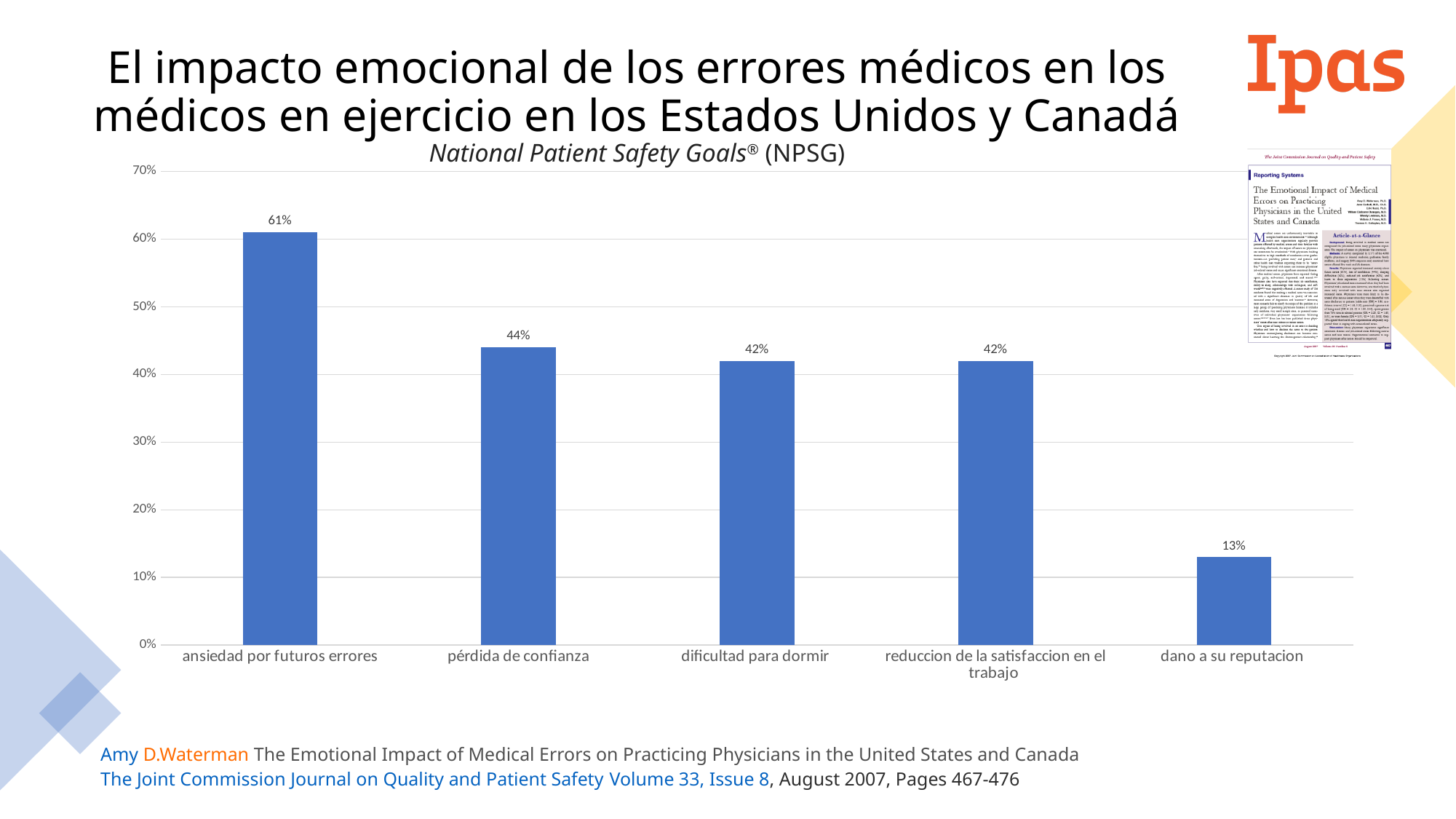
What is the value for "dano a su reputacion"? 13% Is the value for "ansiedad por futuros errores" greater or less than 50%? greater What is the value for "ansiedad por futuros errores"? 61% What is the difference between the values for "ansiedad por futuros errores" and "pérdida de confianza"? 17% Which category has the lowest value? dano a su reputacion What is the difference between the values for "dificultad para dormir" and "dano a su reputacion"? 29% Which category has the highest value? ansiedad por futuros errores Which is larger, the value for "pérdida de confianza" or the value for "dano a su reputacion"? pérdida de confianza What kind of chart is shown on the slide? bar chart What is the value for "pérdida de confianza"? 44% What is the value for "reduccion de la satisfaccion en el trabajo"? 42% How many categories are shown on the x axis? 5